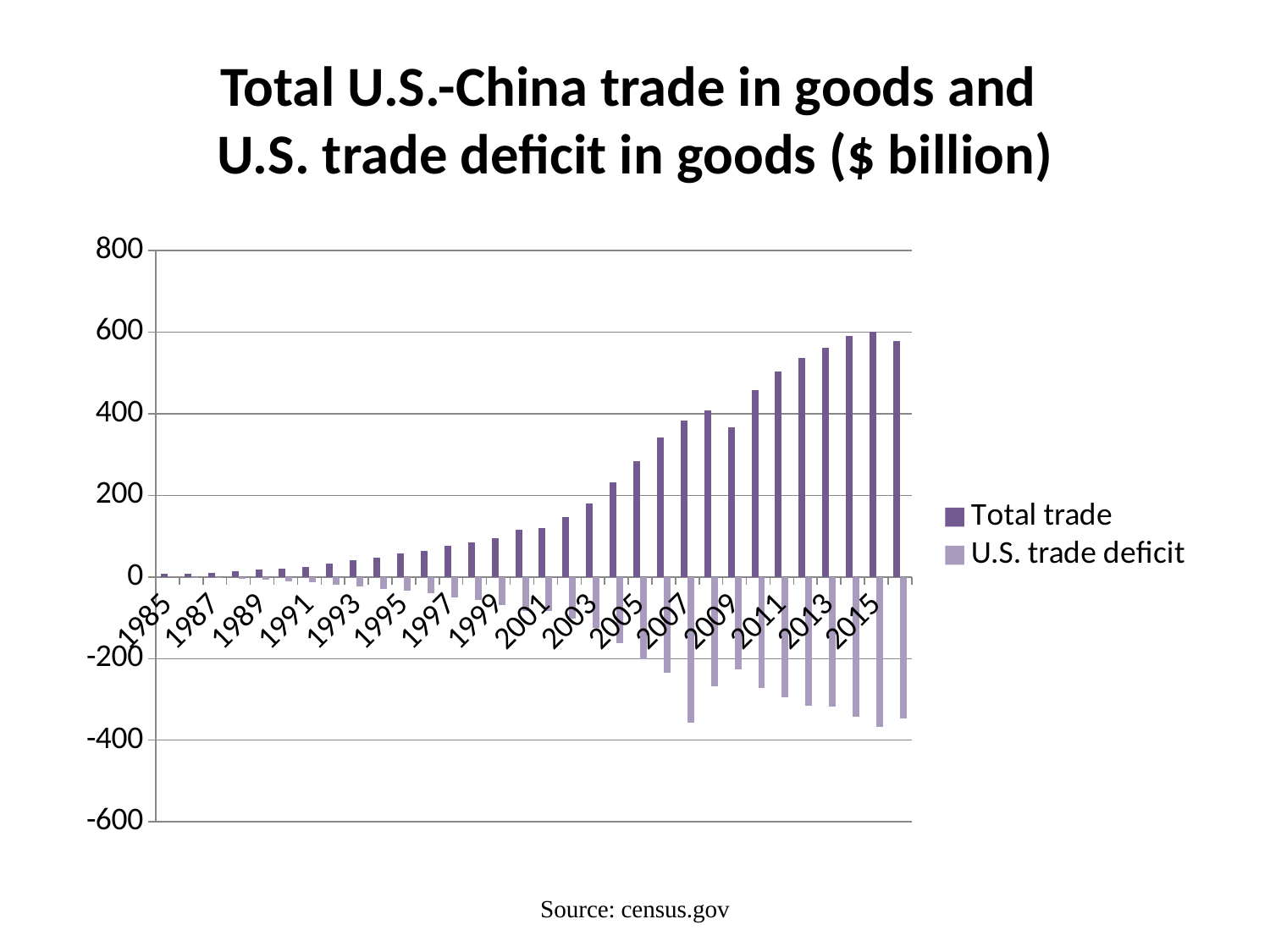
What kind of chart is shown on the slide? Bar chart Is the U.S. trade deficit value for 2015 greater or less than -200? less In which year is the U.S. trade deficit bar the longest (most negative)? 2015 Does the Total trade series generally rise or fall from 1985 to 2015? Rise How many series does the legend list? 2 Is the Total trade value for 2011 greater or less than 400? greater Is the Total trade value for 2005 greater or less than 200? greater What are the two series named in the legend? Total trade and U.S. trade deficit Which is larger, the Total trade value for 2013 or for 2009? 2013 What is the title of the chart? Total U.S.-China trade in goods and U.S. trade deficit in goods ($ billion)